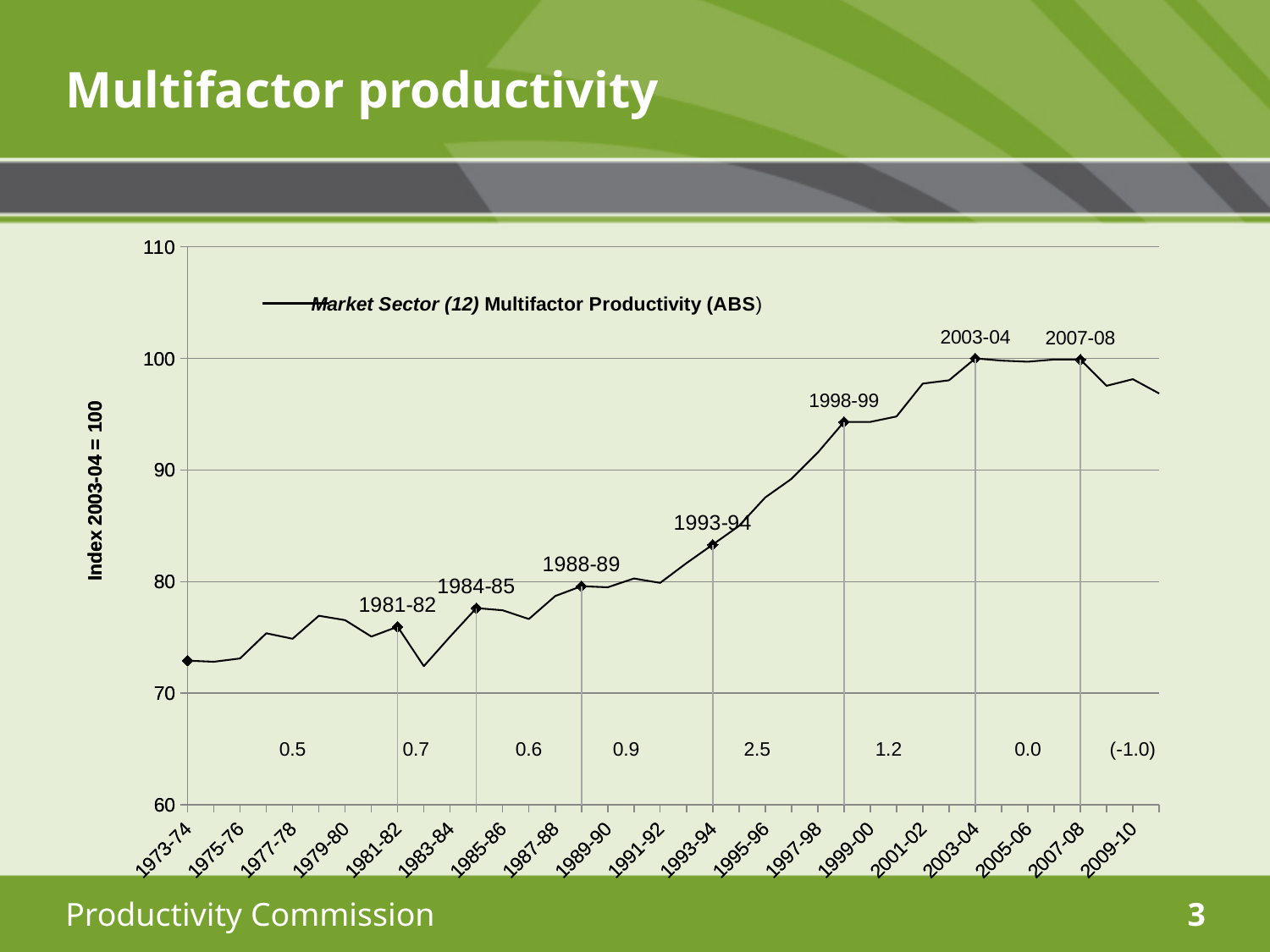
Is the value for 1998-99 greater or less than 90? greater How many series does the legend list? 1 What is the title of the vertical axis? Index 2003-04 = 100 Is the value for 1973-74 greater or less than 80? less What growth figure is printed for the period between 1993-94 and 1998-99? 2.5 What growth figure is printed for the period after 2007-08? (-1.0) What is the index value for 2003-04? 100 Is the value for 1993-94 greater or less than 80? greater What is the name of the series shown in the legend? Market Sector (12) Multifactor Productivity (ABS) Does the index generally rise or fall from 1973-74 to 2003-04? rise What kind of chart is shown on the slide? line chart Which has the higher index value, 1988-89 or 1998-99? 1998-99